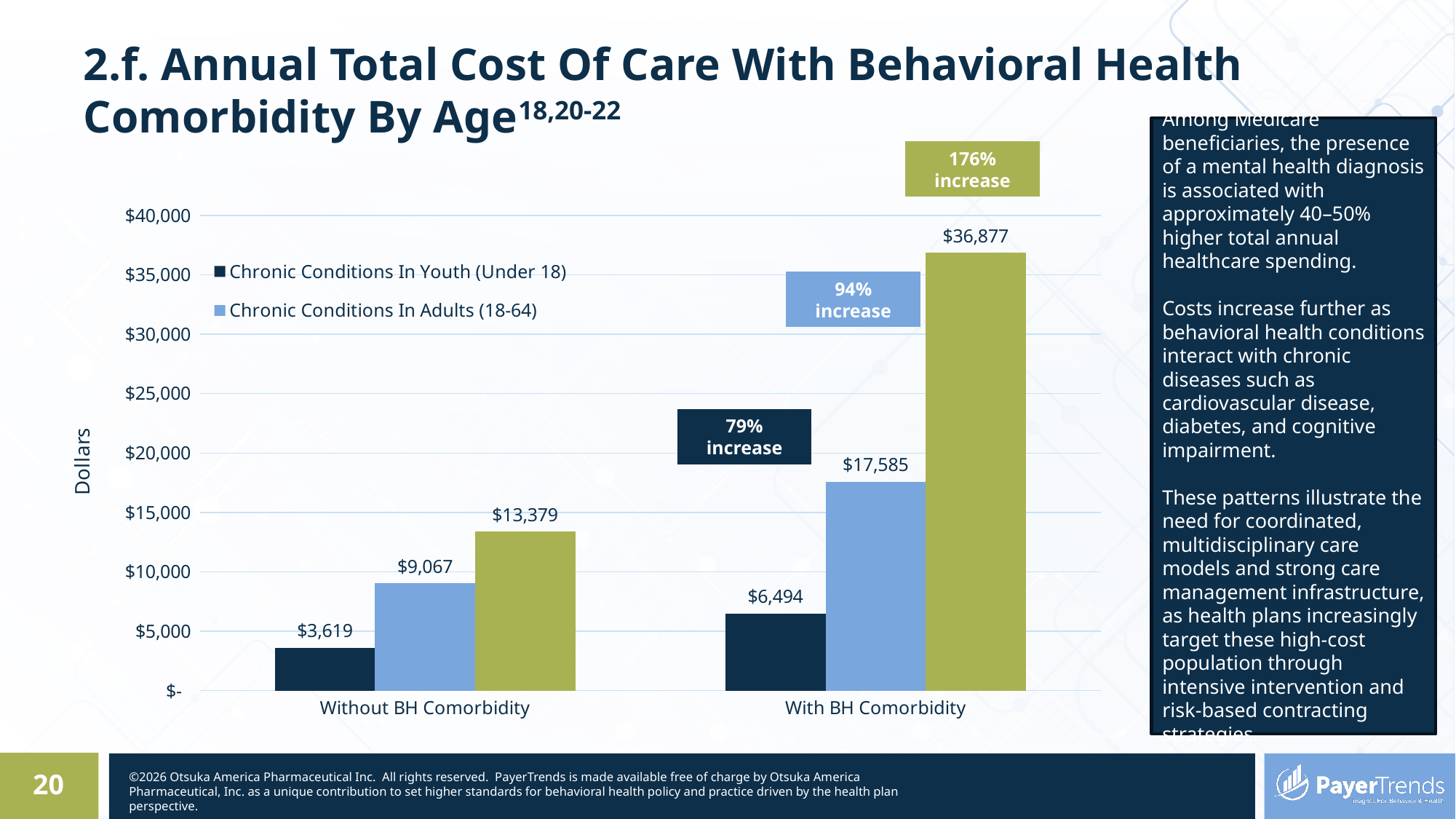
What is the annual total cost of care for Chronic Conditions In Adults (18-64) with BH comorbidity? $17,585 How much higher is the cost for Chronic Conditions In Adults (18-64) with BH comorbidity than without BH comorbidity? $8,518 What is the value for Chronic Conditions In Adults (18-64) in the Without BH Comorbidity category? $9,067 What kind of chart is shown on the slide? Bar chart What is the highest value shown on the chart? $36,877 What is the value for Chronic Conditions In Youth (Under 18) in the With BH Comorbidity category? $6,494 How many categories are shown on the x axis? 2 Which is larger: Adults (18-64) without BH comorbidity or Youth (Under 18) with BH comorbidity? Adults (18-64) without BH comorbidity What is the annual total cost of care for Chronic Conditions In Youth (Under 18) without BH comorbidity? $3,619 How many series does the legend list? 2 What is the difference between the Youth (Under 18) values with and without BH comorbidity? $2,875 What percentage increase is labeled above the Youth (Under 18) bars? 79% increase